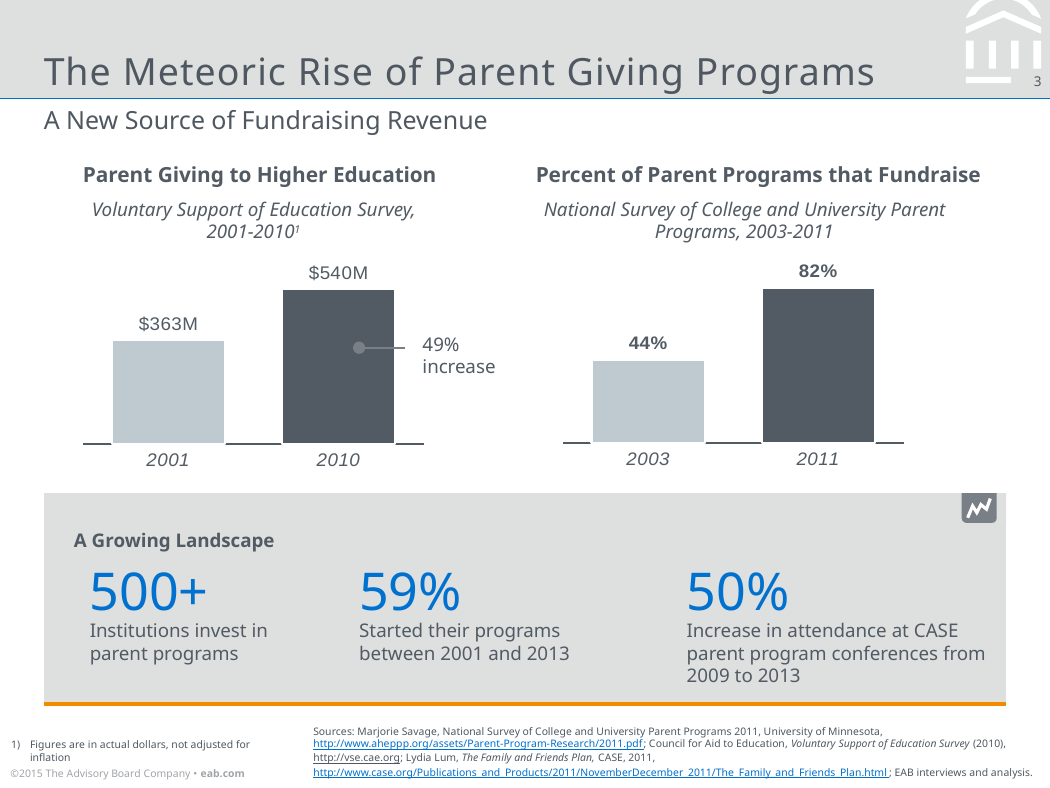
In the 'Percent of Parent Programs that Fundraise' chart, is the value for 2011 larger or smaller than the value for 2003? larger In the 'Percent of Parent Programs that Fundraise' chart, what is the value for 2011? 82% In the 'Percent of Parent Programs that Fundraise' chart, what is the difference between the 2011 and 2003 values? 38 percentage points How many bars are shown in the 'Parent Giving to Higher Education' chart? 2 In the 'Percent of Parent Programs that Fundraise' chart, what is the value for 2003? 44% In the 'Parent Giving to Higher Education' chart, what is the difference between the 2010 and 2001 values? $177M In the 'Parent Giving to Higher Education' chart, what is the value for 2001? $363M In the 'Parent Giving to Higher Education' chart, what percentage increase is annotated next to the 2010 bar? 49% increase In the 'Parent Giving to Higher Education' chart, which year has the higher value? 2010 What type of chart is the 'Percent of Parent Programs that Fundraise' chart? bar chart In the 'Parent Giving to Higher Education' chart, what is the value for 2010? $540M In the 'Percent of Parent Programs that Fundraise' chart, which year has the lower value? 2003